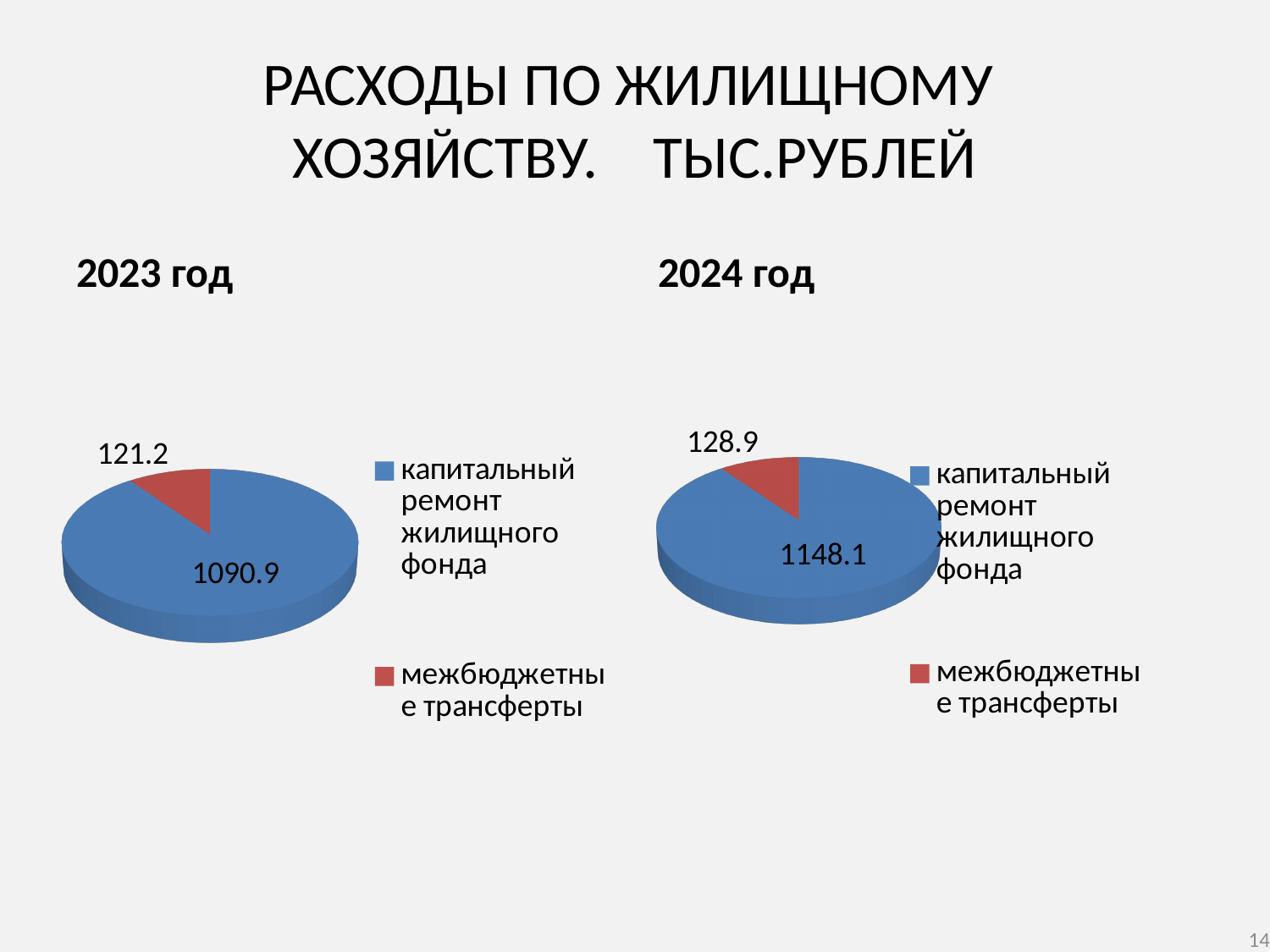
How many categories does the 2024 год chart show? 2 In the 2023 год chart, what is the value for капитальный ремонт жилищного фонда? 1090.9 Is the value for межбюджетные трансферты larger in the 2023 год chart or the 2024 год chart? 2024 год In the 2023 год chart, what is the difference between капитальный ремонт жилищного фонда and межбюджетные трансферты? 969.7 In the 2023 год chart, which category has the smallest slice? межбюджетные трансферты In the 2024 год chart, what is the value for межбюджетные трансферты? 128.9 In the 2023 год chart, what colour is the slice for межбюджетные трансферты? red In the 2023 год chart, what is the value for межбюджетные трансферты? 121.2 What type of chart is used for 2023 год? pie chart What is the difference between the капитальный ремонт жилищного фонда values in the 2024 год chart and the 2023 год chart? 57.2 In the 2024 год chart, what is the value for капитальный ремонт жилищного фонда? 1148.1 In the 2024 год chart, which category has the largest slice? капитальный ремонт жилищного фонда